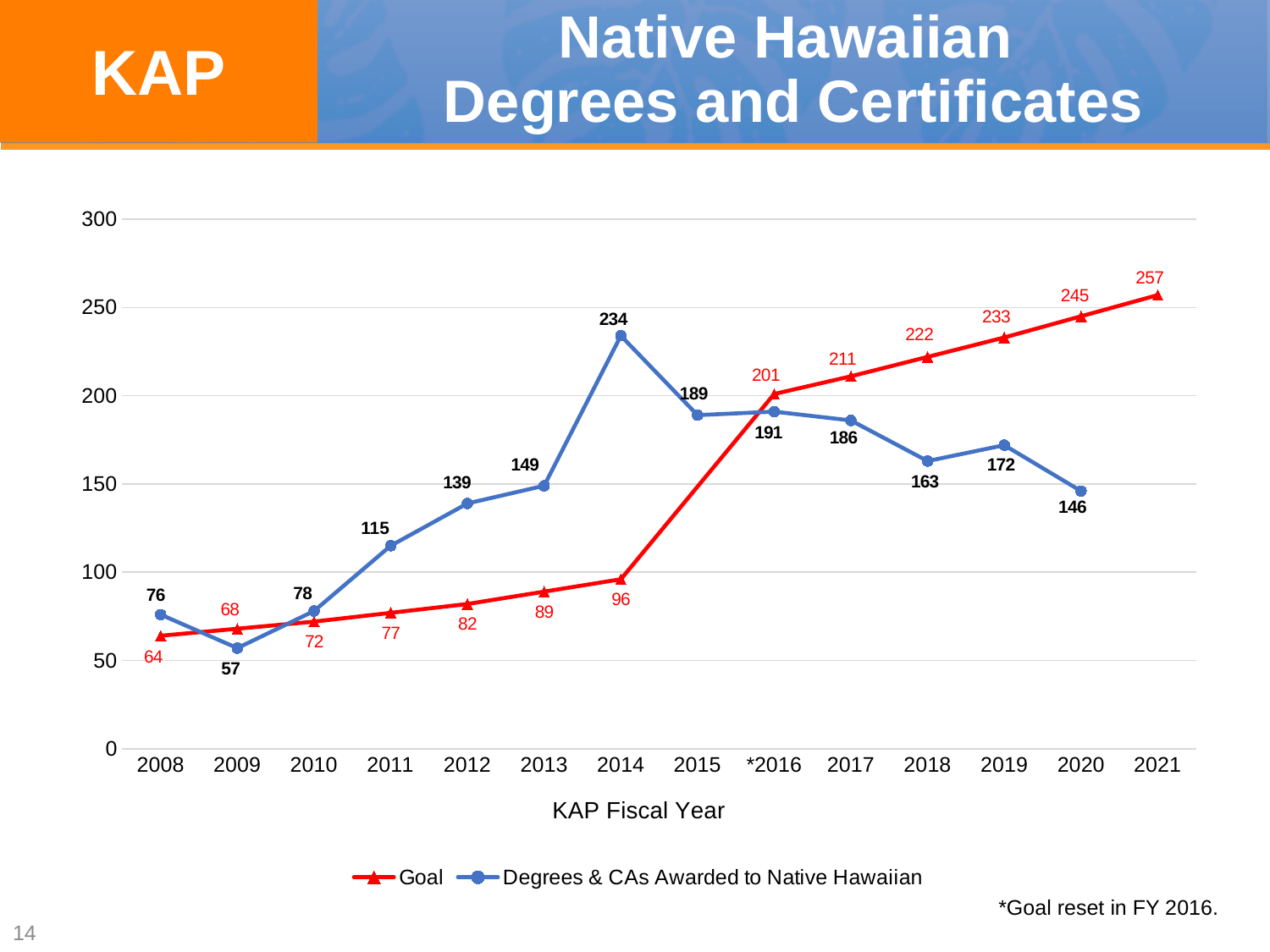
What was the Goal value for 2021? 257 How many fiscal years are shown on the x axis? 14 What kind of chart is shown on the slide? line chart How many series does the legend list? 2 What is the x-axis title of the chart? KAP Fiscal Year In which year was the number of Degrees & CAs Awarded to Native Hawaiian highest? 2014 What was the number of Degrees & CAs Awarded to Native Hawaiian in 2020? 146 Does the Goal series rise or fall from 2016 to 2021? rise In which year was the number of Degrees & CAs Awarded to Native Hawaiian lowest? 2009 In 2014, which was larger: the Goal or the Degrees & CAs Awarded to Native Hawaiian? Degrees & CAs Awarded to Native Hawaiian What is the difference between the Goal and the Degrees & CAs Awarded to Native Hawaiian in 2020? 99 What was the number of Degrees & CAs Awarded to Native Hawaiian in 2014? 234